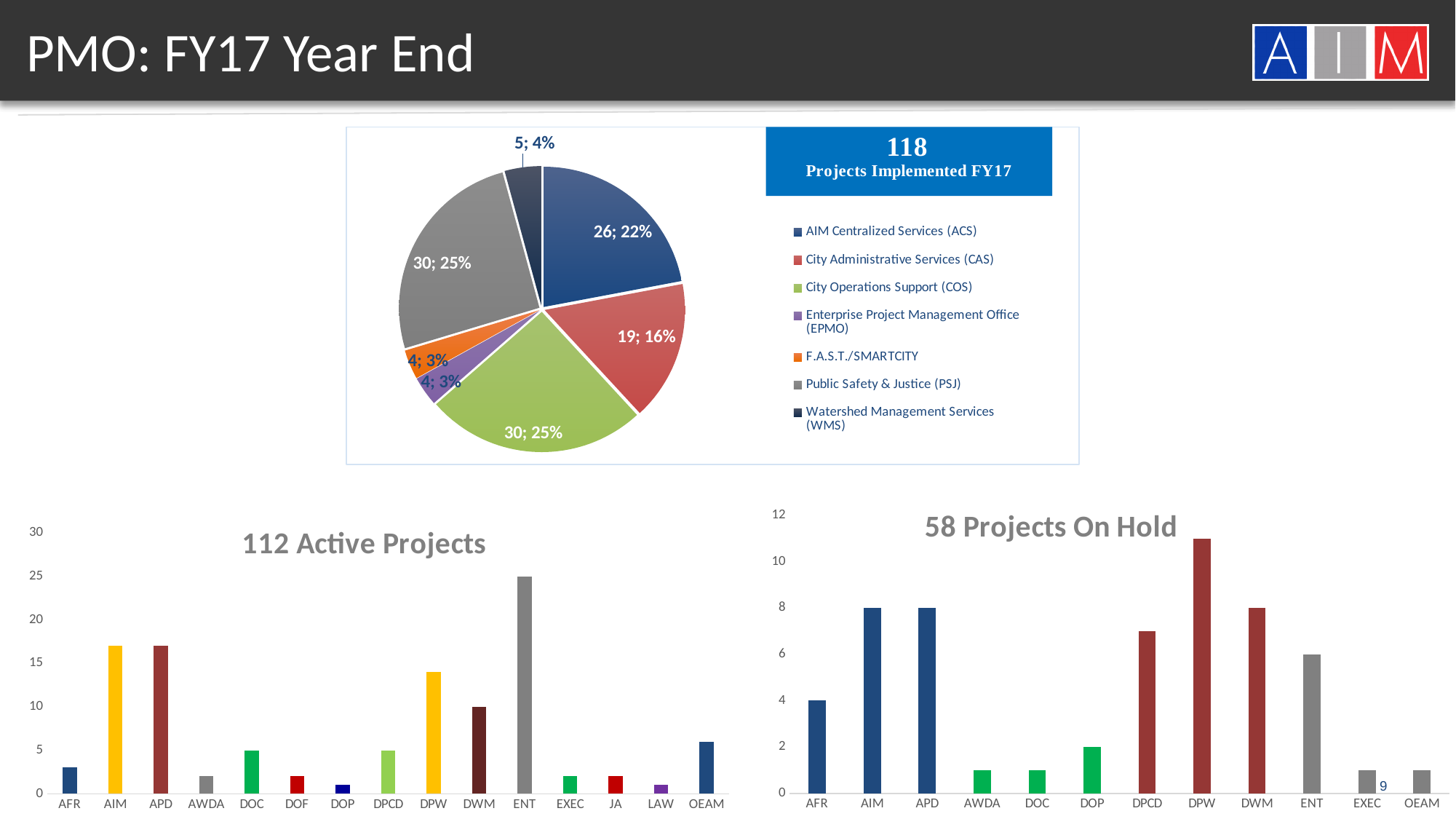
In the '58 Projects On Hold' chart, is the value for DPCD greater or less than 6? greater In the '58 Projects On Hold' chart, how many categories are shown on the x axis? 12 What kind of chart is the chart at the top of the slide? Pie chart In the pie chart, what is the data label shown for City Operations Support (COS)? 30; 25% In the '112 Active Projects' chart, which category has the highest value? ENT In the pie chart, what percentage share does City Administrative Services (CAS) have? 16% In the pie chart, which is larger: AIM Centralized Services (ACS) or City Administrative Services (CAS)? AIM Centralized Services (ACS) In the pie chart, what is the difference between the count for AIM Centralized Services (ACS) and City Administrative Services (CAS)? 7 In the '112 Active Projects' chart, how many categories are shown on the x axis? 15 How many entries does the legend of the pie chart list? 7 In the '112 Active Projects' chart, is the value for DPW greater or less than 10? greater In the '58 Projects On Hold' chart, which category has the highest value? DPW